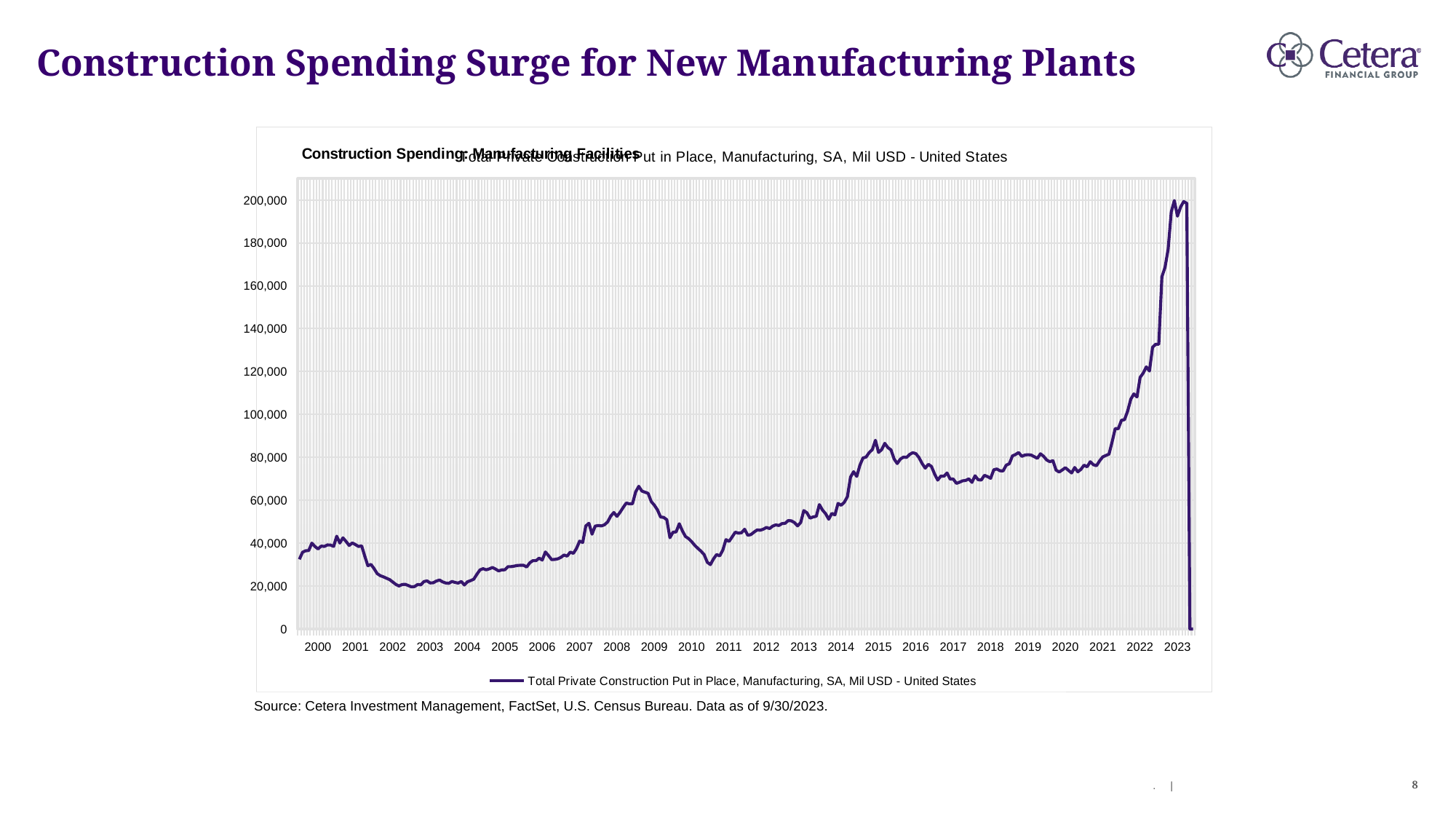
Is the peak value in 2023 greater or less than 180,000? greater What is the highest value shown on the y axis? 200,000 What kind of chart is shown on the slide? line chart What is the legend entry for the plotted series? Total Private Construction Put in Place, Manufacturing, SA, Mil USD - United States Does the line rise or fall from its 2008 peak to 2010? fall How many series does the legend list? 1 Is the lowest value in 2010 greater or less than 40,000? less Is the peak value in 2015 greater or less than 60,000? greater Does the line rise or fall from 2021 to 2023? rise How many year labels are shown on the x axis? 24